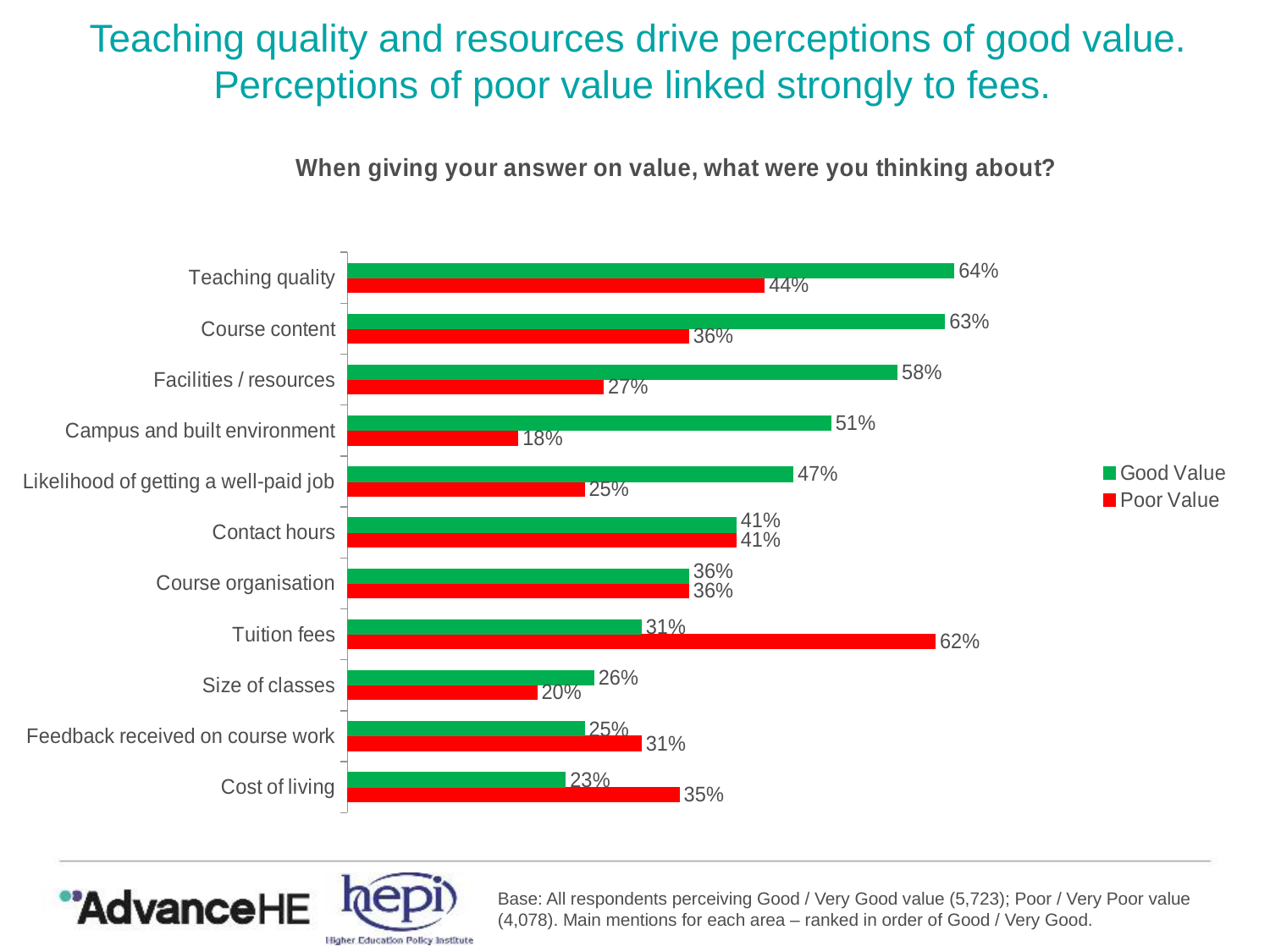
What is the Poor Value percentage for Tuition fees? 62% Which is larger for Cost of living: the Good Value or the Poor Value percentage? Poor Value What is the Good Value percentage for Teaching quality? 64% Which category has the lowest Good Value percentage? Cost of living What colour represents the Poor Value series? Red What kind of chart is shown on the slide? Bar chart How many categories are shown on the chart? 11 What is the difference between the Good Value and Poor Value percentages for Facilities / resources? 31% Which category has the highest Poor Value percentage? Tuition fees How many series does the legend list? 2 What is the Poor Value percentage for Campus and built environment? 18% Which category has the highest Good Value percentage? Teaching quality